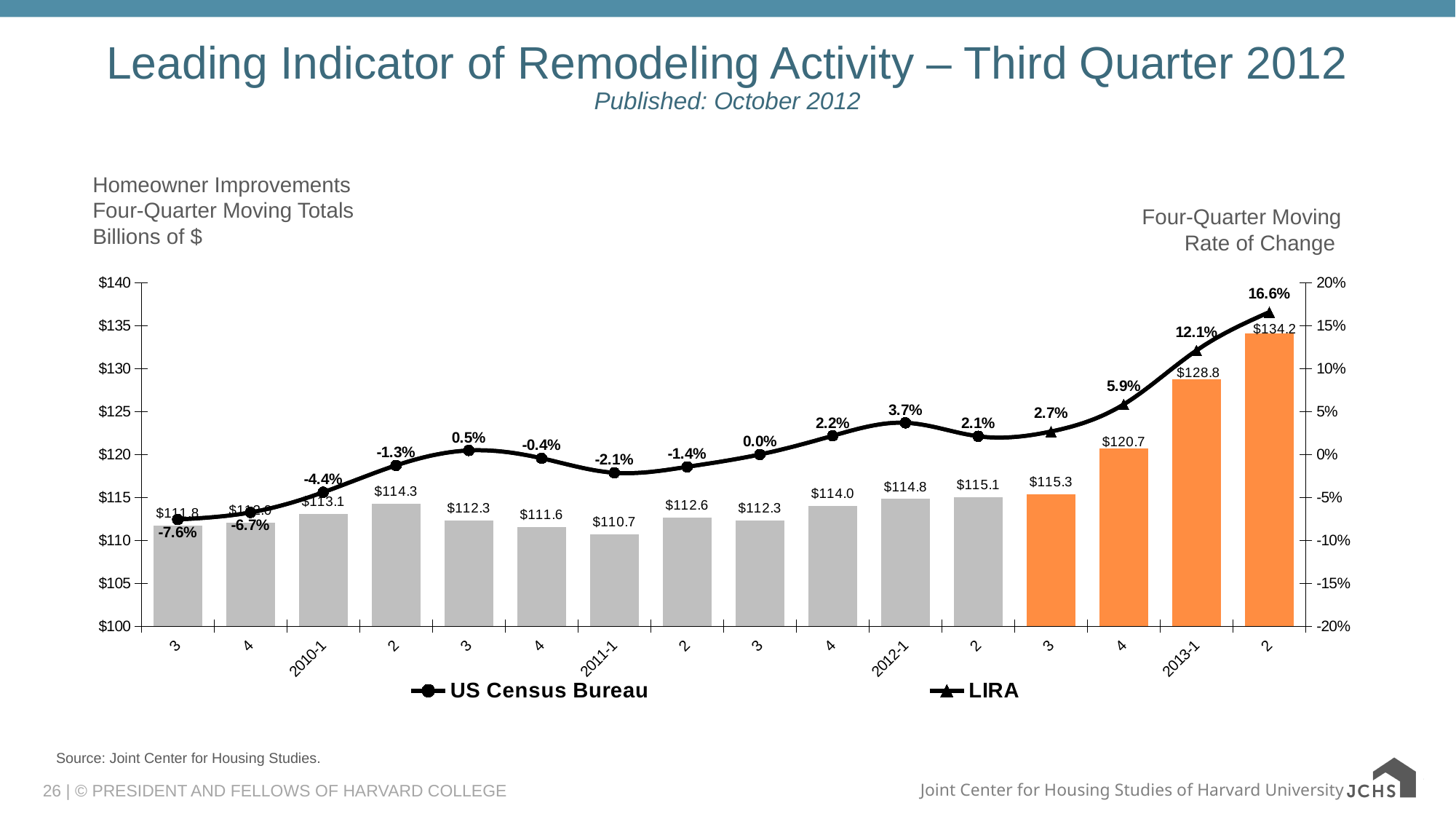
What is the difference between the last bar ($134.2) and the 2013-1 bar ($128.8)? $5.4 Does the rate of change line rise or fall over the last four quarters (2012 Q3 to 2013 Q2)? Rise What are the two legend entries on the chart? US Census Bureau and LIRA What is the lowest four-quarter moving rate of change labeled on the line? -7.6% How many bars are plotted on the chart? 16 Which bar is taller: 2010-1 or 2012-1? 2012-1 Which quarter has the lowest four-quarter moving total bar? 2011-1 ($110.7) What four-quarter moving rate of change is labeled at 2012-1? 3.7% What is the four-quarter moving total shown for 2013-1? $128.8 What kind of chart is this? Combined bar and line chart What is the highest four-quarter moving total value labeled on any bar? $134.2 How many series does the legend list? 2